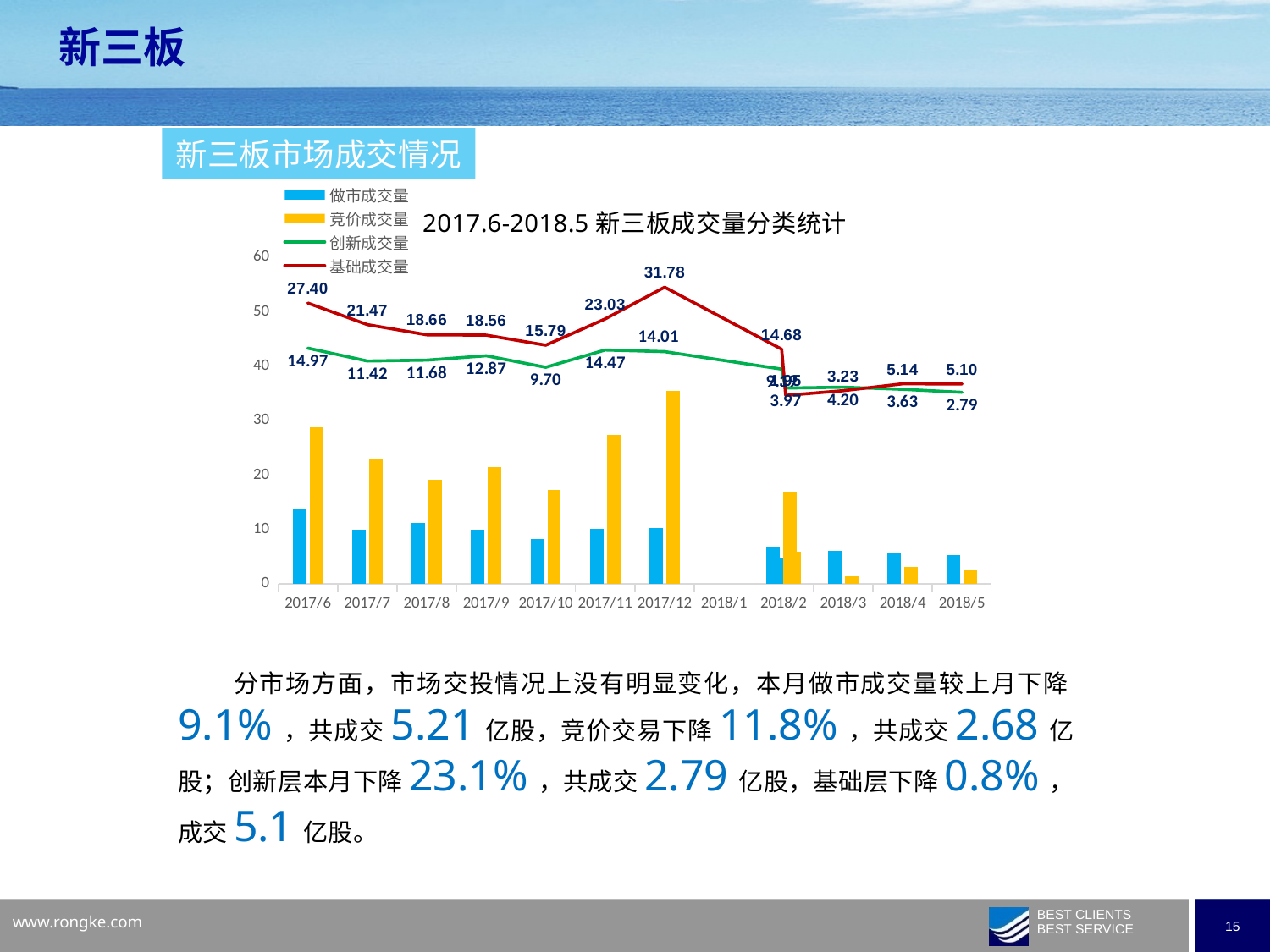
How many months are shown on the x axis of the chart? 12 How many series does the chart legend list? 4 In which month is 基础成交量 highest? 2017/12 For 2017/11, which is larger: 基础成交量 or 创新成交量? 基础成交量 What kind of chart is shown on the slide? A combined bar and line chart Is the 竞价成交量 bar for 2017/6 greater or less than 20? greater Is the 做市成交量 bar for 2018/5 greater or less than 10? less What is the title of the chart? 2017.6-2018.5 新三板成交量分类统计 What is the 创新成交量 value for 2017/6? 14.97 What is the difference between the 基础成交量 values for 2017/6 and 2017/7? 5.93 In which month is 创新成交量 lowest? 2018/5 What is the 基础成交量 value for 2017/12? 31.78